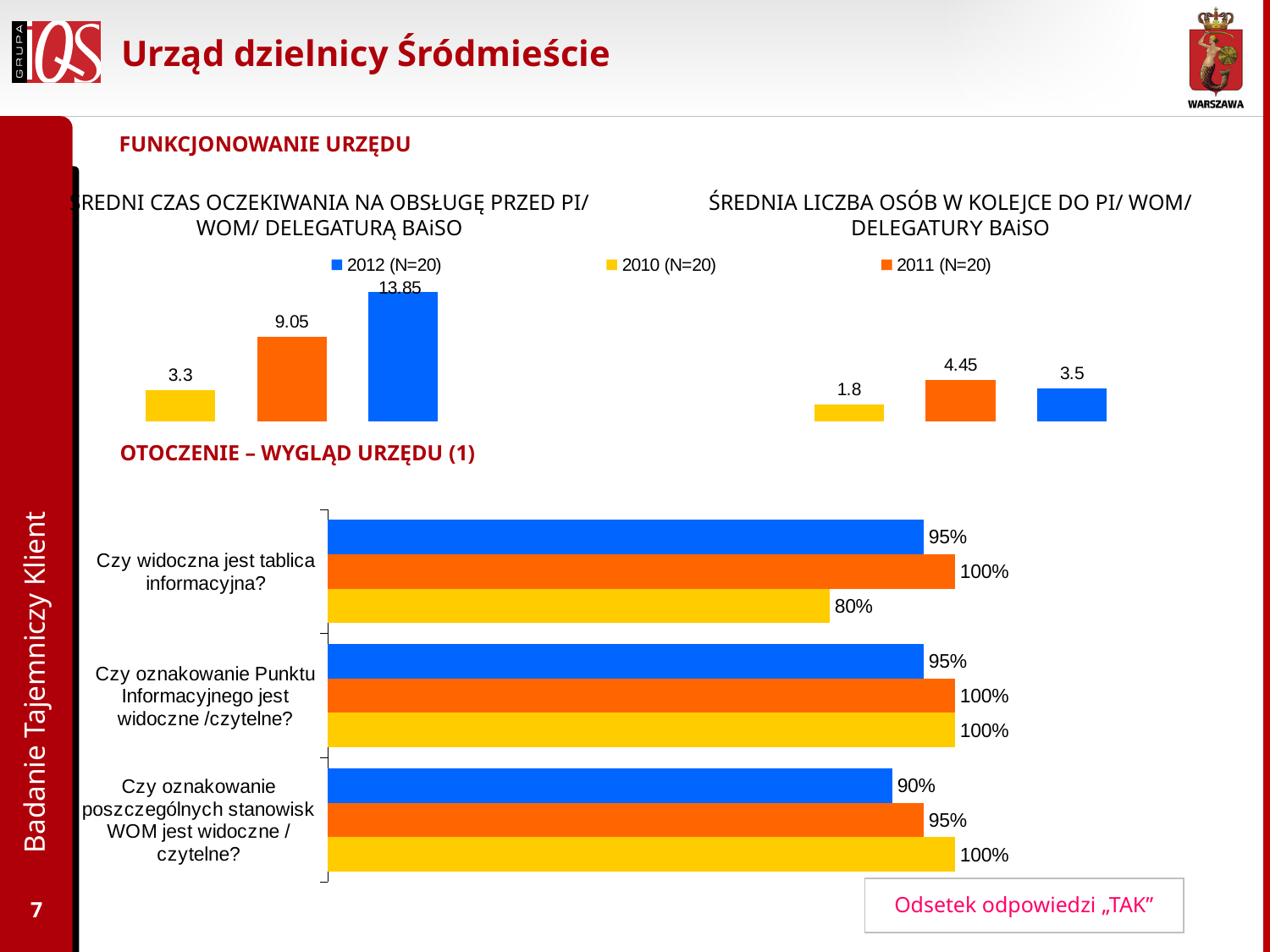
In the top-left chart (ŚREDNI CZAS OCZEKIWANIA NA OBSŁUGĘ), what is the value for 2012 (N=20)? 13.85 In the bottom chart (OTOCZENIE – WYGLĄD URZĘDU), what is the yellow (2010) value for 'Czy widoczna jest tablica informacyjna?'? 80% In the top-right chart (ŚREDNIA LICZBA OSÓB W KOLEJCE), what is the difference between the 2012 and 2010 values? 1.7 In the top-right chart (ŚREDNIA LICZBA OSÓB W KOLEJCE), what is the value for 2011 (N=20)? 4.45 In the top-right chart (ŚREDNIA LICZBA OSÓB W KOLEJCE), which year has the lowest value? 2010 (N=20) In the top-left chart (ŚREDNI CZAS OCZEKIWANIA NA OBSŁUGĘ), which year has the highest value? 2012 (N=20) In the top-left chart (ŚREDNI CZAS OCZEKIWANIA NA OBSŁUGĘ), what is the value for 2010 (N=20)? 3.3 How many question categories are shown in the bottom chart (OTOCZENIE – WYGLĄD URZĘDU)? 3 In the bottom chart (OTOCZENIE – WYGLĄD URZĘDU), what is the blue (2012) value for 'Czy oznakowanie poszczególnych stanowisk WOM jest widoczne / czytelne?'? 90% In the top-right chart (ŚREDNIA LICZBA OSÓB W KOLEJCE), which is larger: the value for 2011 or for 2012? 2011 What type of chart is the bottom chart (OTOCZENIE – WYGLĄD URZĘDU)? Bar chart In the top-left chart (ŚREDNI CZAS OCZEKIWANIA NA OBSŁUGĘ), what is the difference between the 2011 and 2010 values? 5.75